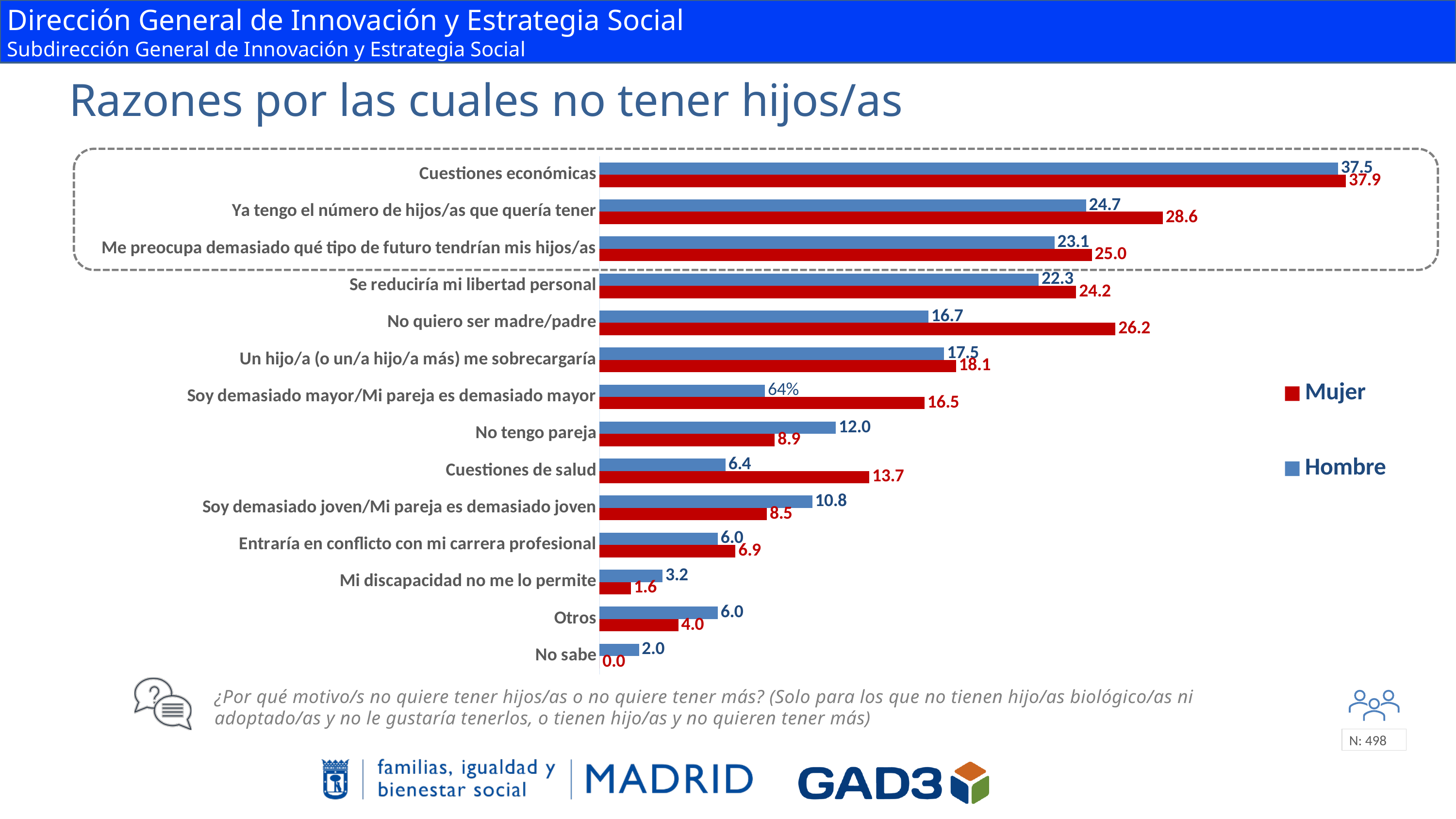
For 'No tengo pareja', which is larger, the Mujer value or the Hombre value? Hombre What is the difference between the Mujer and Hombre values for 'No quiero ser madre/padre'? 9.5 What is the Hombre value for 'Ya tengo el número de hijos/as que quería tener'? 24.7 Which category has the highest Mujer value? Cuestiones económicas How many categories are shown in the chart? 14 Which category has the lowest Mujer value? No sabe What is the Mujer value for 'Cuestiones económicas'? 37.9 What kind of chart is shown on the slide? Bar chart What is the Hombre value for 'Cuestiones de salud'? 6.4 How many series does the legend list? 2 What is the Mujer value for 'No quiero ser madre/padre'? 26.2 Which colour represents the Mujer series? Red